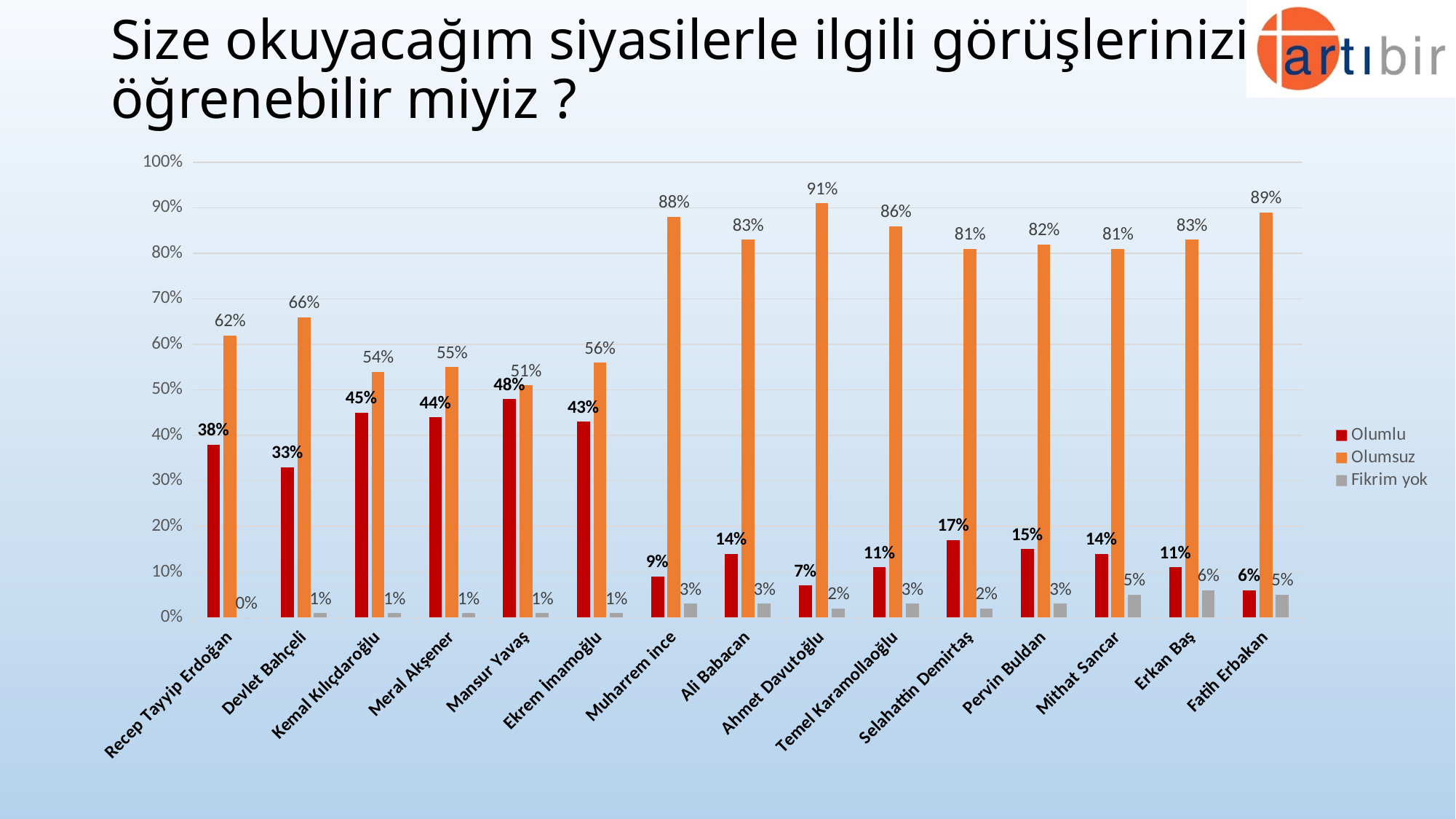
What is the Fikrim yok value for Erkan Baş? 6% What is the difference between the Olumsuz and Olumlu values for Recep Tayyip Erdoğan? 24% What colour represents the Olumsuz series in the legend? Orange Which politician has the lowest Olumsuz value? Mansur Yavaş What is the Olumlu value for Mansur Yavaş? 48% How many series does the legend list? 3 Which is larger: the Olumlu value for Kemal Kılıçdaroğlu or the Olumlu value for Meral Akşener? Kemal Kılıçdaroğlu What kind of chart is shown on the slide? Bar chart How many politicians are shown on the x axis? 15 What is the Olumsuz value for Ahmet Davutoğlu? 91% Which politician has the lowest Olumlu value? Fatih Erbakan Which politician has the highest Olumlu value? Mansur Yavaş